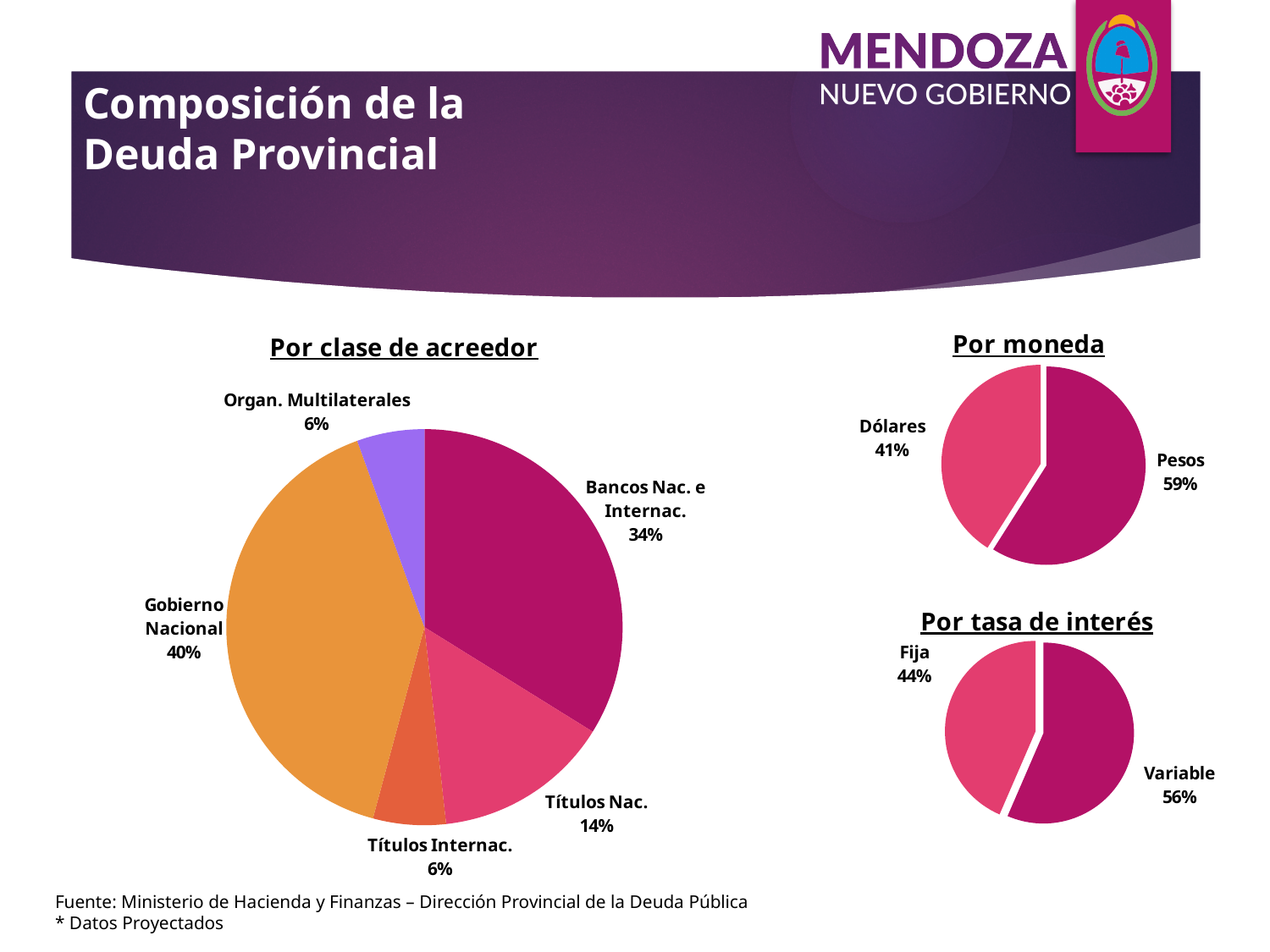
In the 'Por clase de acreedor' chart, what share does Bancos Nac. e Internac. have? 34% In the 'Por moneda' chart, what share is in Dólares? 41% In the 'Por moneda' chart, which category has the larger share? Pesos In the 'Por tasa de interés' chart, what is the difference between Variable and Fija? 12% In the 'Por tasa de interés' chart, what share is Variable? 56% How many pie charts are shown on the slide? 3 What kind of chart is 'Por clase de acreedor'? Pie chart In the 'Por clase de acreedor' chart, what is the difference between the shares of Gobierno Nacional and Títulos Nac.? 26% In the 'Por clase de acreedor' chart, which is larger: Bancos Nac. e Internac. or Títulos Nac.? Bancos Nac. e Internac. How many categories are shown in the 'Por clase de acreedor' chart? 5 In the 'Por clase de acreedor' chart, what share does Gobierno Nacional have? 40% In the 'Por clase de acreedor' chart, which category has the largest share? Gobierno Nacional